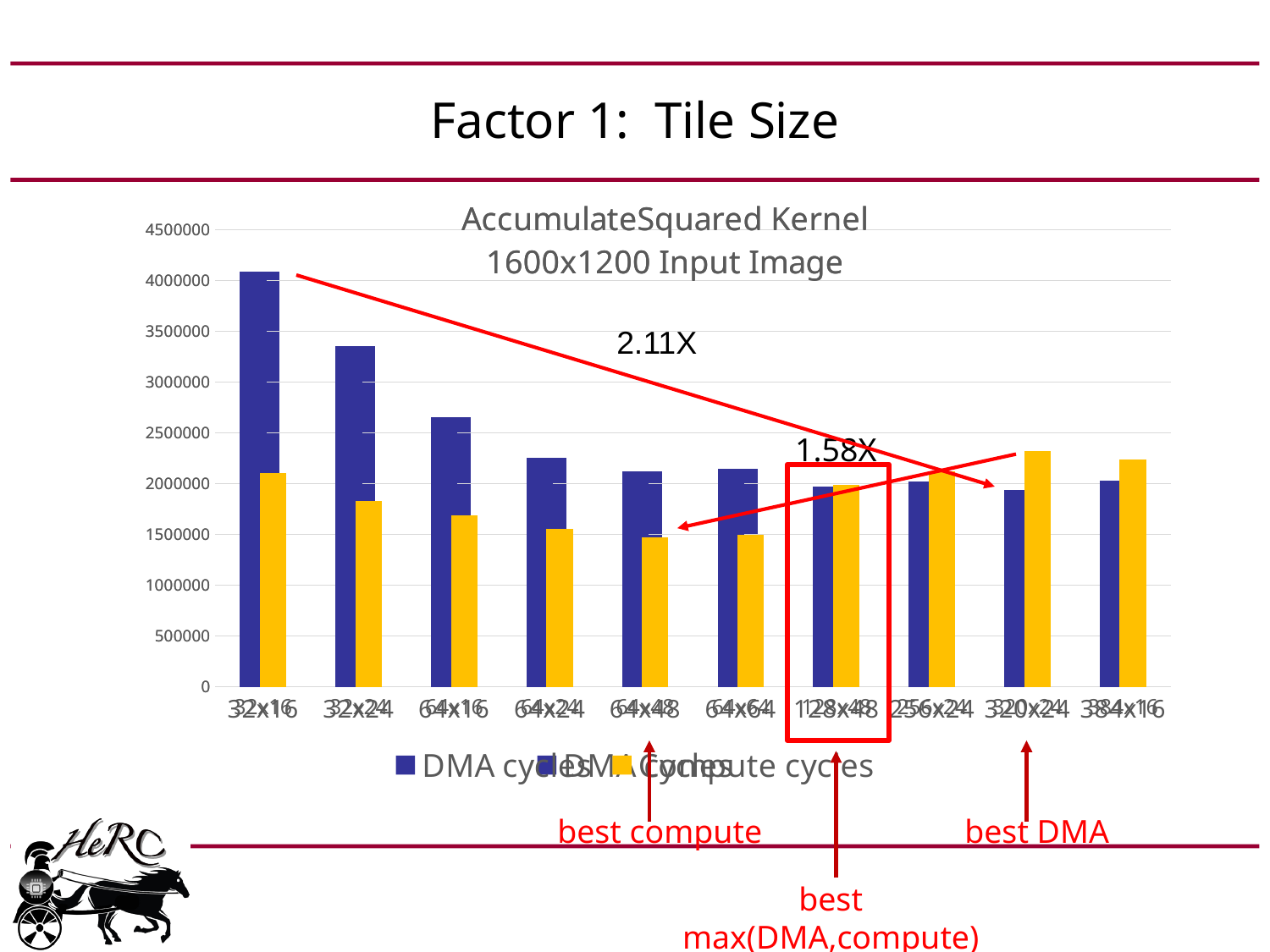
What is the title of the chart? AccumulateSquared Kernel 1600x1200 Input Image How many tile-size categories are shown on the x axis? 10 Which tile size has the highest DMA cycles? 32x16 Is the Compute cycles value for 64x24 greater or less than 2000000? less For the 320x24 tile size, which is larger: DMA cycles or Compute cycles? Compute cycles Do the DMA cycles rise or fall from 32x16 to 64x48? fall What kind of chart is shown on the slide? bar chart For the 32x16 tile size, which is larger: DMA cycles or Compute cycles? DMA cycles How many series does the legend list? 2 Which tile size has the lowest Compute cycles? 64x48 Is the DMA cycles value for 32x24 greater or less than 3000000? greater Is the DMA cycles value for 64x16 greater or less than 2500000? greater